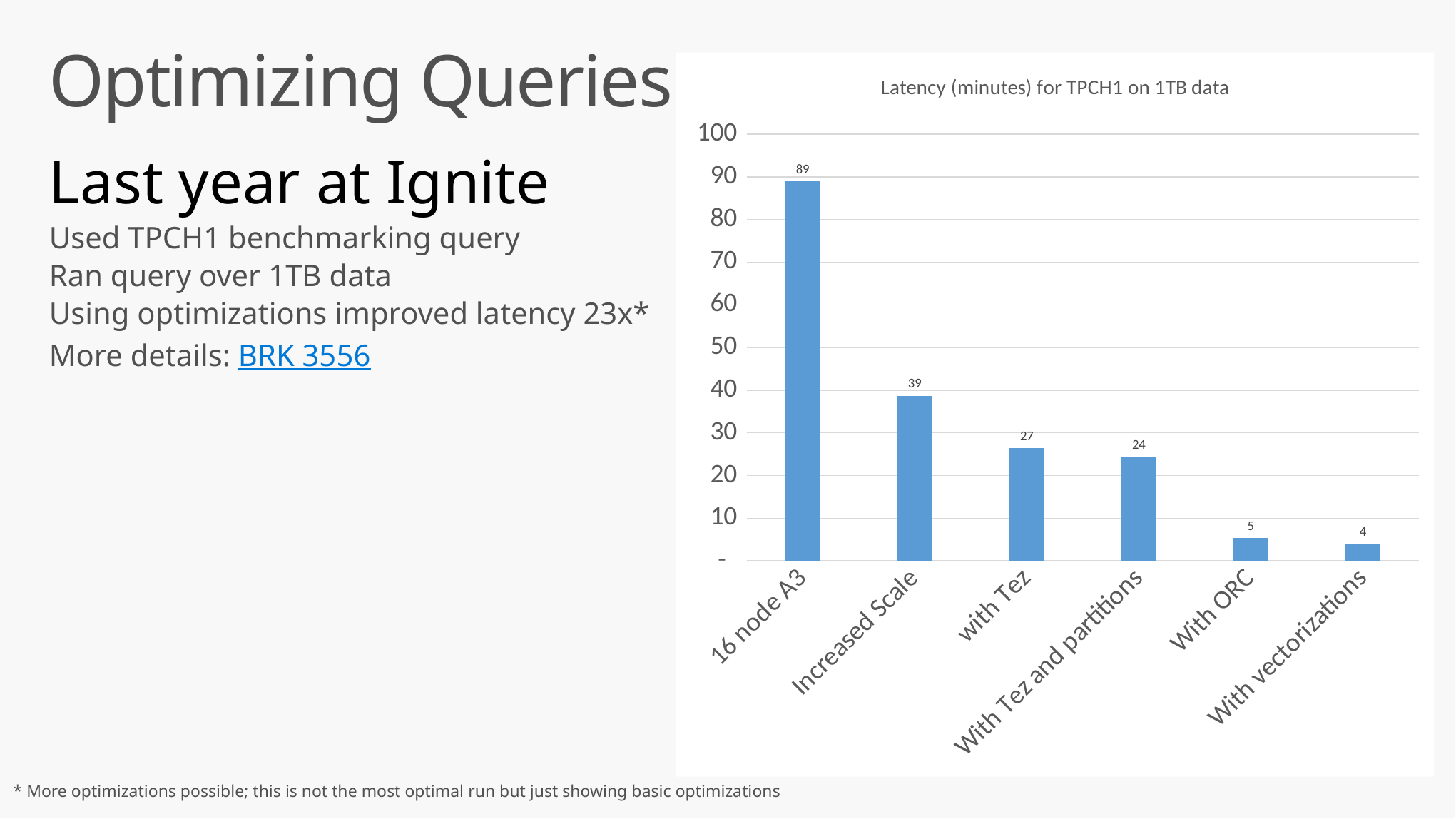
Which category has the lowest latency? With vectorizations Do the latency values rise or fall from left to right along the x axis? fall What is the difference in latency between "16 node A3" and "Increased Scale"? 50 Which category has the highest latency? 16 node A3 How many categories are shown on the x axis? 6 What is the latency value for "With Tez and partitions"? 24 What is the latency value for "16 node A3"? 89 What kind of chart is shown on the slide? bar chart What is the latency value for "With vectorizations"? 4 Is the value for "Increased Scale" greater or less than 50? less Which has a higher latency, "Increased Scale" or "with Tez"? Increased Scale What is the difference in latency between "with Tez" and "With ORC"? 22